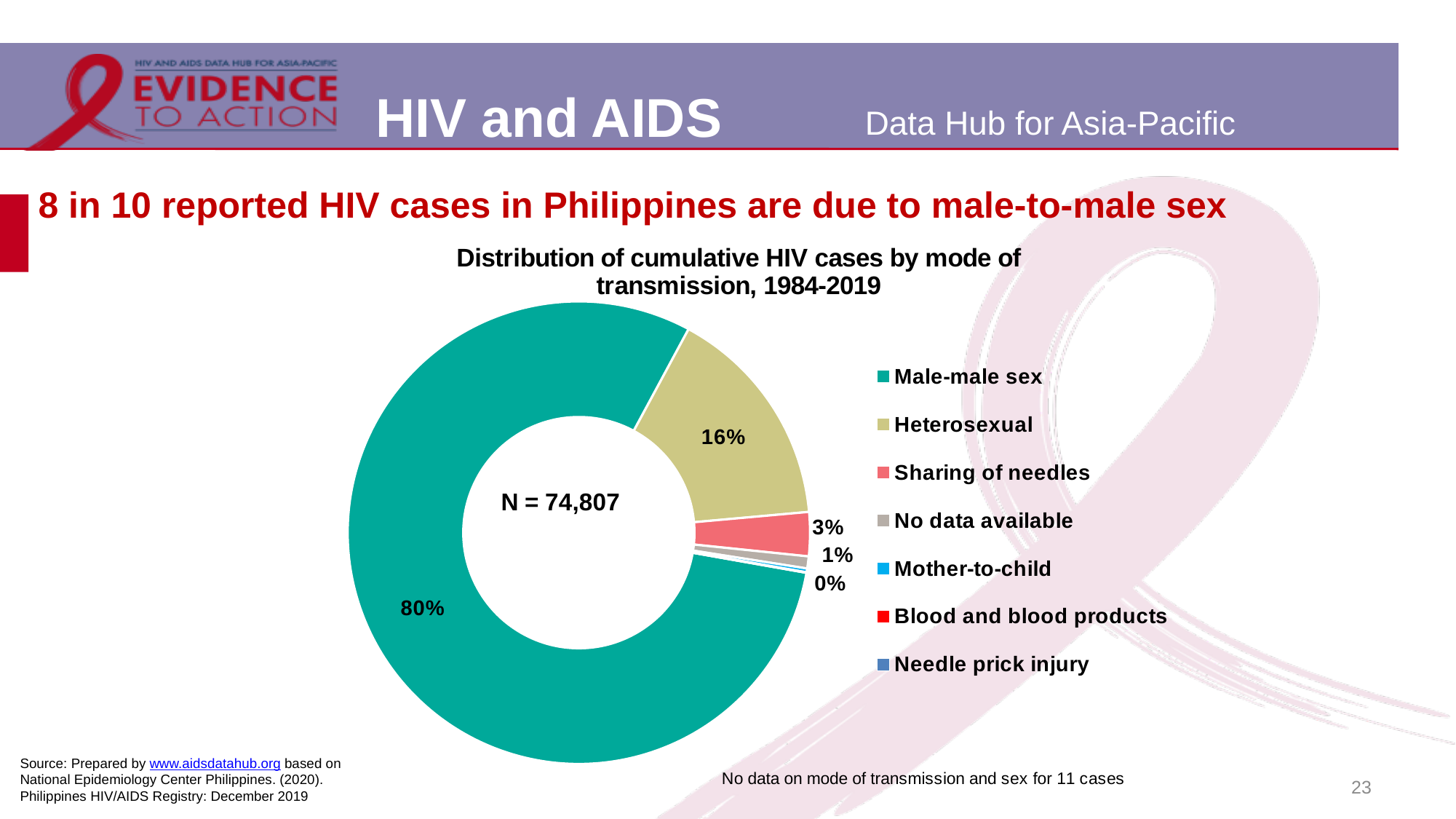
What total number of cases (N) is shown in the centre of the chart? N = 74,807 What kind of chart is shown on the slide? Pie chart (donut) Which accounts for a larger share of cases: heterosexual transmission or sharing of needles? Heterosexual What is the title of the chart? Distribution of cumulative HIV cases by mode of transmission, 1984-2019 What share of cumulative HIV cases is attributed to mother-to-child transmission? 0% What share of cumulative HIV cases is attributed to male-male sex? 80% What share of cumulative HIV cases falls under 'No data available'? 1% Which mode of transmission accounts for the largest share of cases? Male-male sex What share of cumulative HIV cases is attributed to sharing of needles? 3% How many modes of transmission does the legend list? 7 What is the difference in percentage points between the male-male sex share and the heterosexual share? 64 percentage points What share of cumulative HIV cases is attributed to heterosexual transmission? 16%